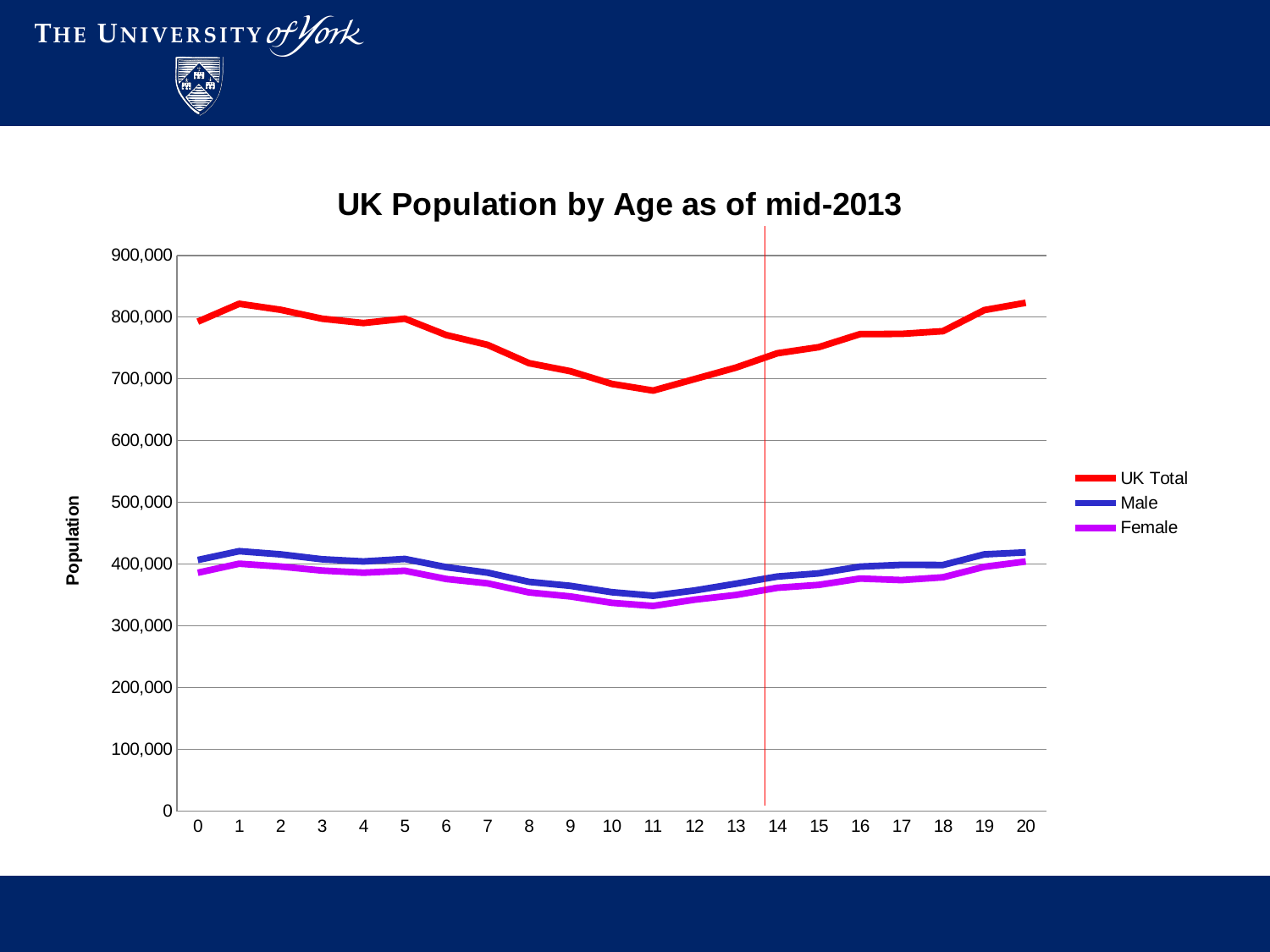
What is the label on the vertical axis? Population What kind of chart is shown on the slide? line chart Is the UK Total value at age 1 greater or less than 800,000? greater How many series does the legend list? 3 Is the UK Total value at age 11 greater or less than 700,000? less Is the Female value at age 11 greater or less than 400,000? less At which age is the UK Total population lowest? 11 How many age categories are plotted along the x axis? 21 What is the title of the chart? UK Population by Age as of mid-2013 Which is larger at age 5, the Male value or the Female value? Male Does the UK Total line rise or fall between age 1 and age 11? fall